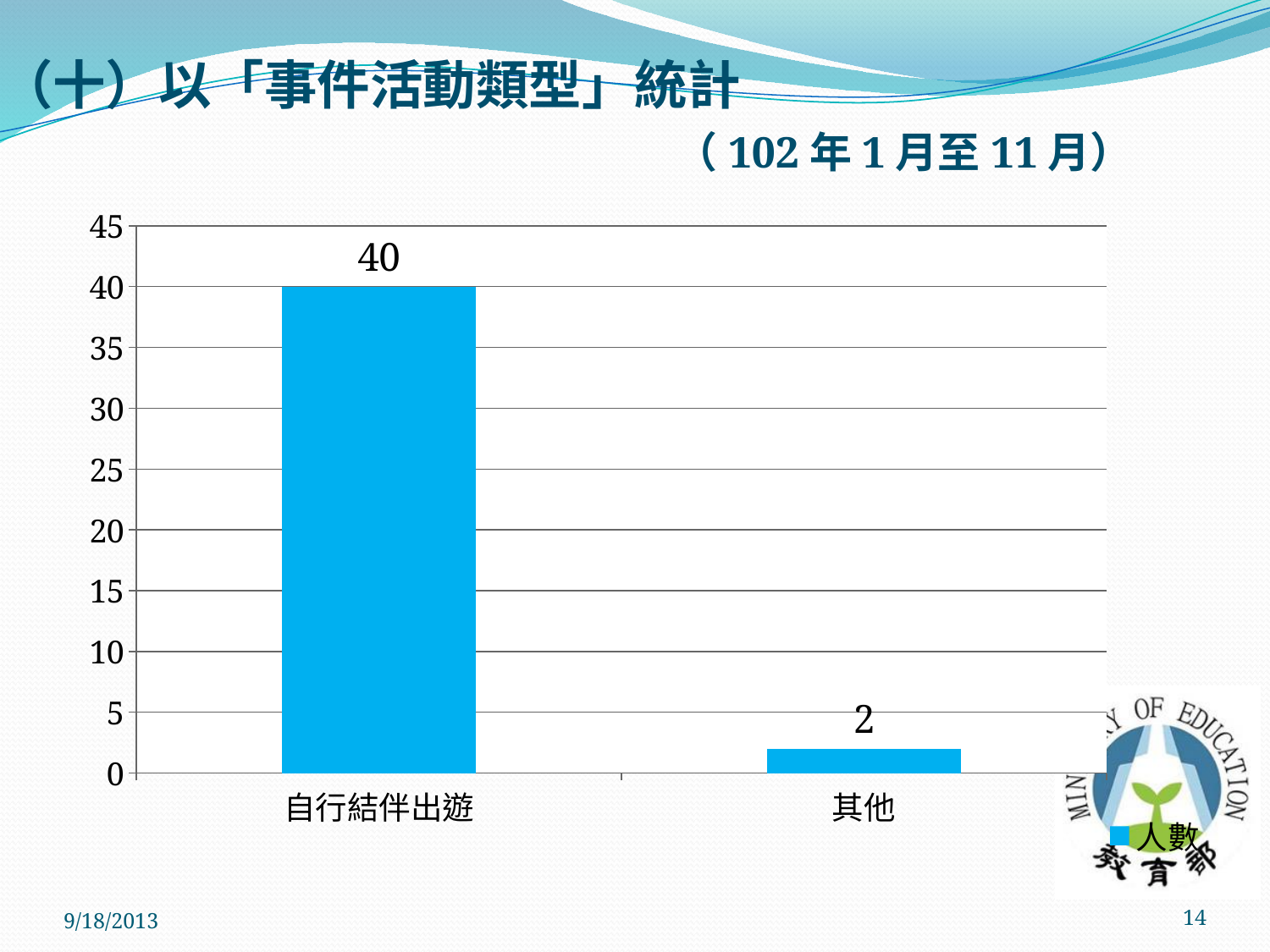
How many categories are shown on the x axis? 2 Is the value for 自行結伴出遊 greater or less than 35? greater Which category has the lowest value? 其他 What kind of chart is shown on the slide? bar chart What is the value for 其他? 2 Which is larger, the value for 自行結伴出遊 or the value for 其他? 自行結伴出遊 What is the value for 自行結伴出遊? 40 Which category has the highest value? 自行結伴出遊 What is the difference between the values for 自行結伴出遊 and 其他? 38 How many series does the legend list? 1 Is the value for 其他 greater or less than 5? less What is the name of the series shown in the legend? 人數